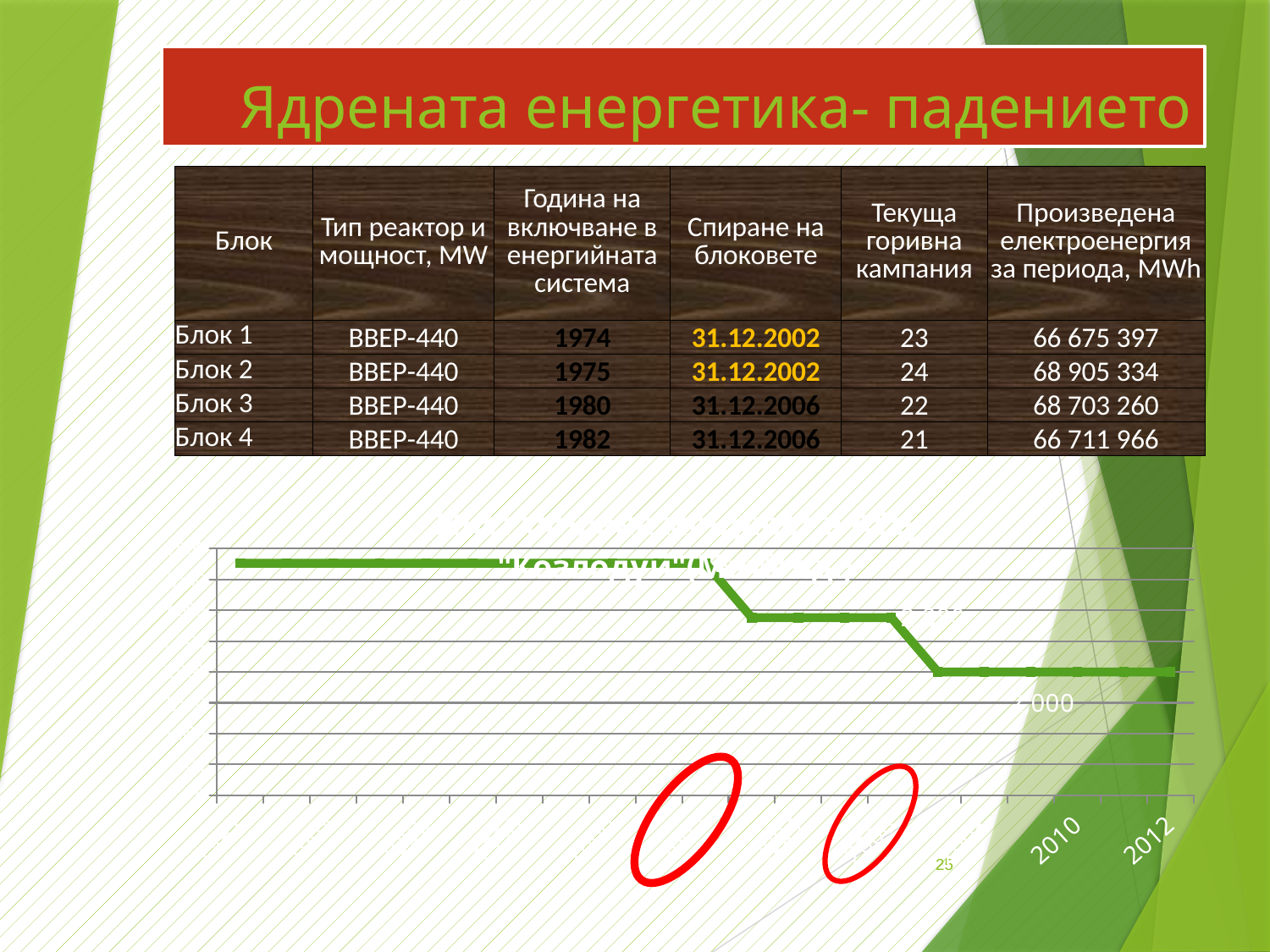
What is the last year label shown on the x axis of the line chart at the bottom of the slide? 2012 What kind of chart is shown at the bottom of the slide? line chart In the line chart at the bottom of the slide, do the values rise or fall from left to right along the x axis? fall In the line chart at the bottom of the slide, does the line rise, fall or stay flat between 2010 and 2012? stays flat What colour is the plotted line in the chart at the bottom of the slide? green